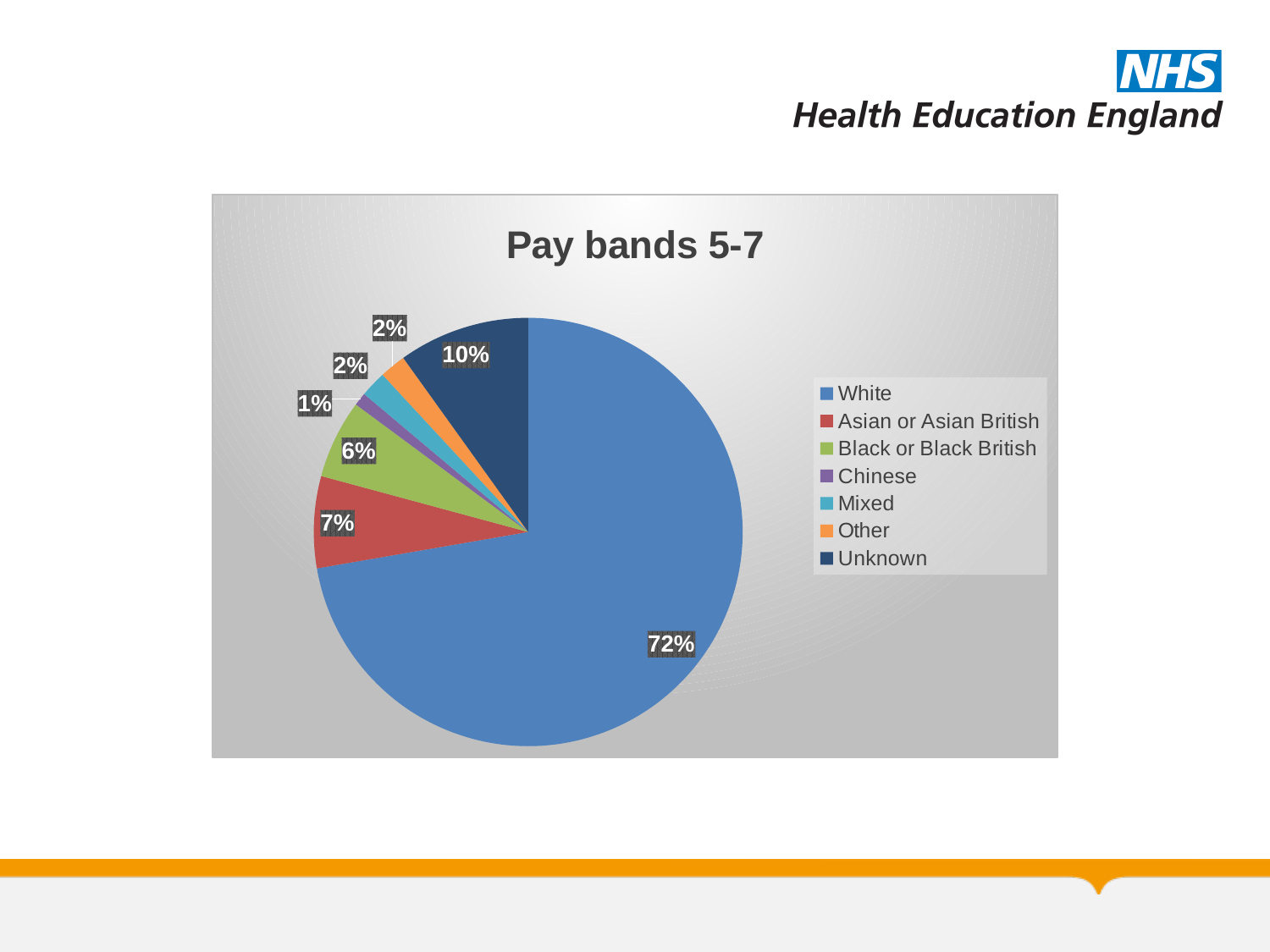
Which category has the largest slice of the pie? White What share of the pie does Unknown represent? 10% Which is larger, the share for Asian or Asian British or the share for Black or Black British? Asian or Asian British What is the value for Asian or Asian British? 7% How many categories does the legend list? 7 What is the difference between the White share and the Unknown share? 62% What is the title of the chart? Pay bands 5-7 What share of the pie does White represent? 72% What is the value for Black or Black British? 6% Which category has the smallest slice of the pie? Chinese What is the value for Chinese? 1% What kind of chart is shown on the slide? Pie chart